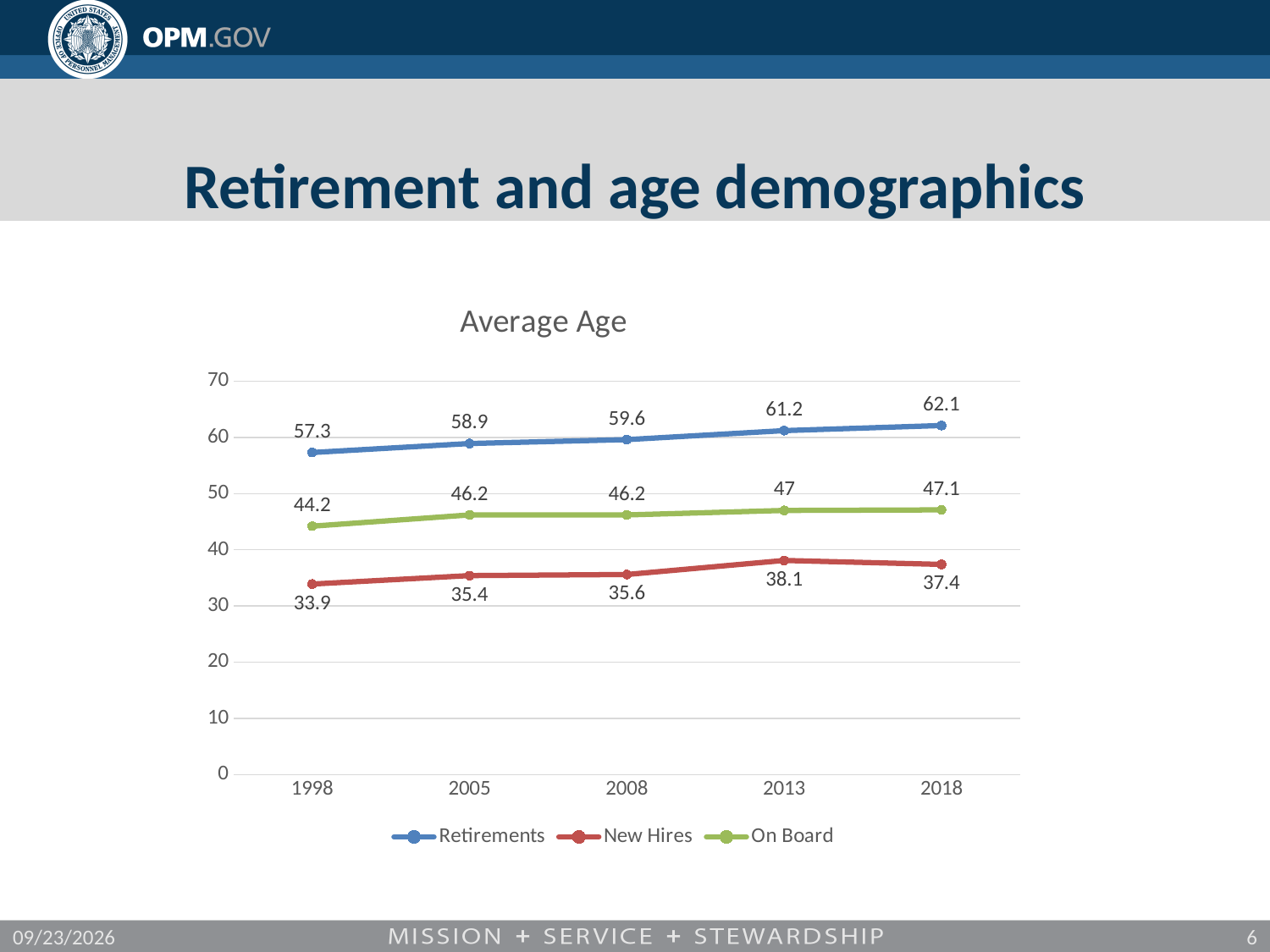
How many series does the legend list? 3 In which year is the average age of New Hires highest? 2013 What is the average age of Retirements in 2018? 62.1 What kind of chart is shown on the slide? Line chart Which is larger in 2008: the average age of On Board employees or of New Hires? On Board Does the average age of Retirements rise or fall from 1998 to 2018? Rise In which year is the average age of Retirements lowest? 1998 Is the average age of Retirements in 2013 greater or less than 60? greater What is the average age of On Board employees in 2013? 47 What is the difference between the Retirements average age in 2018 and in 1998? 4.8 How many years are shown on the x axis? 5 What is the average age of New Hires in 1998? 33.9